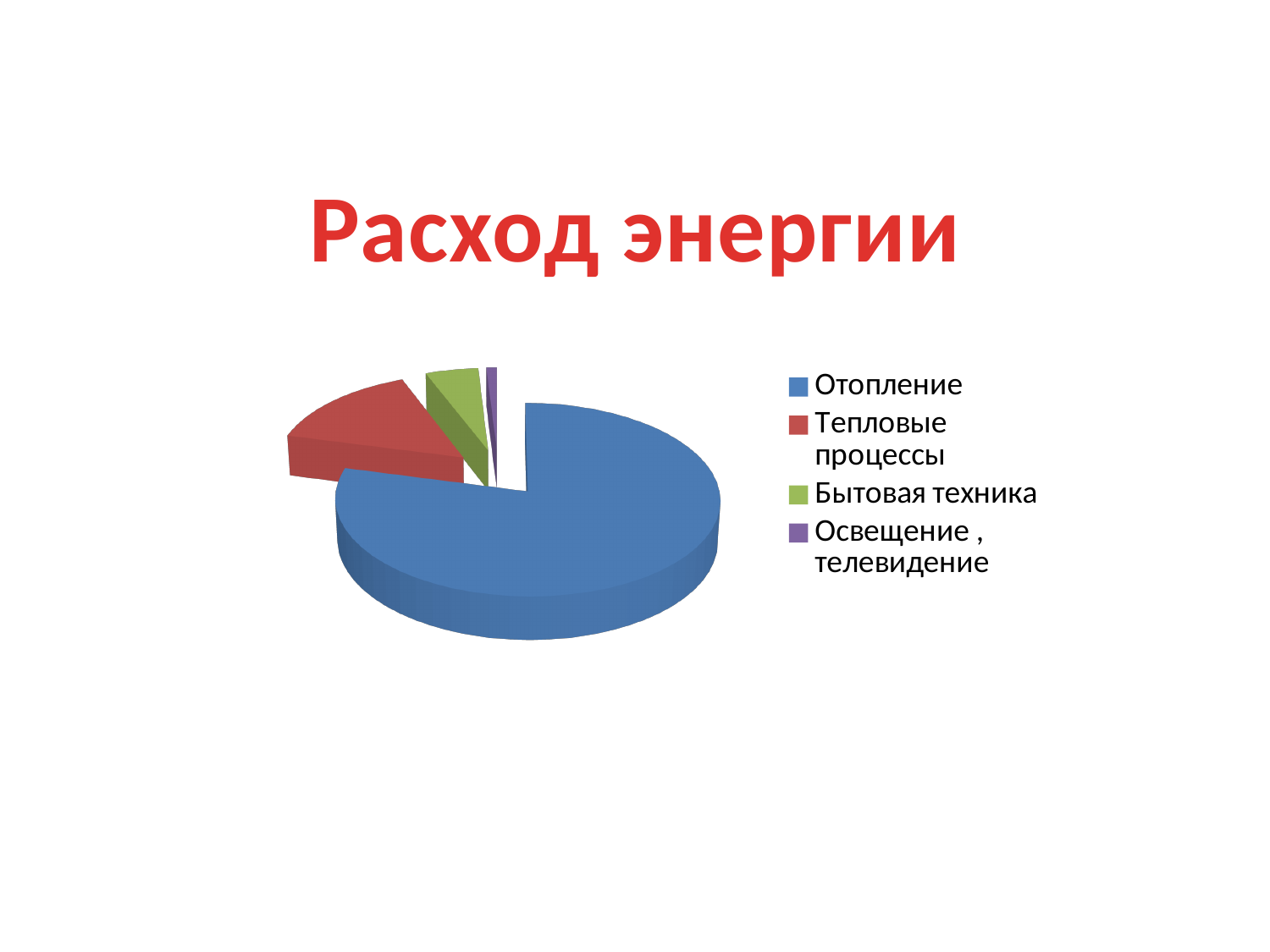
Which category is the second largest slice of the pie? Тепловые процессы Which category has the largest slice of the pie? Отопление How many categories does the pie chart have? 4 What kind of chart is shown on the slide? pie chart Which category has the smallest slice of the pie? Освещение , телевидение Which category is shown in blue? Отопление Which slice is larger, Бытовая техника or Освещение , телевидение? Бытовая техника Which slice is larger, Отопление or Тепловые процессы? Отопление What is the title of the chart? Расход энергии Which slice is larger, Тепловые процессы or Бытовая техника? Тепловые процессы